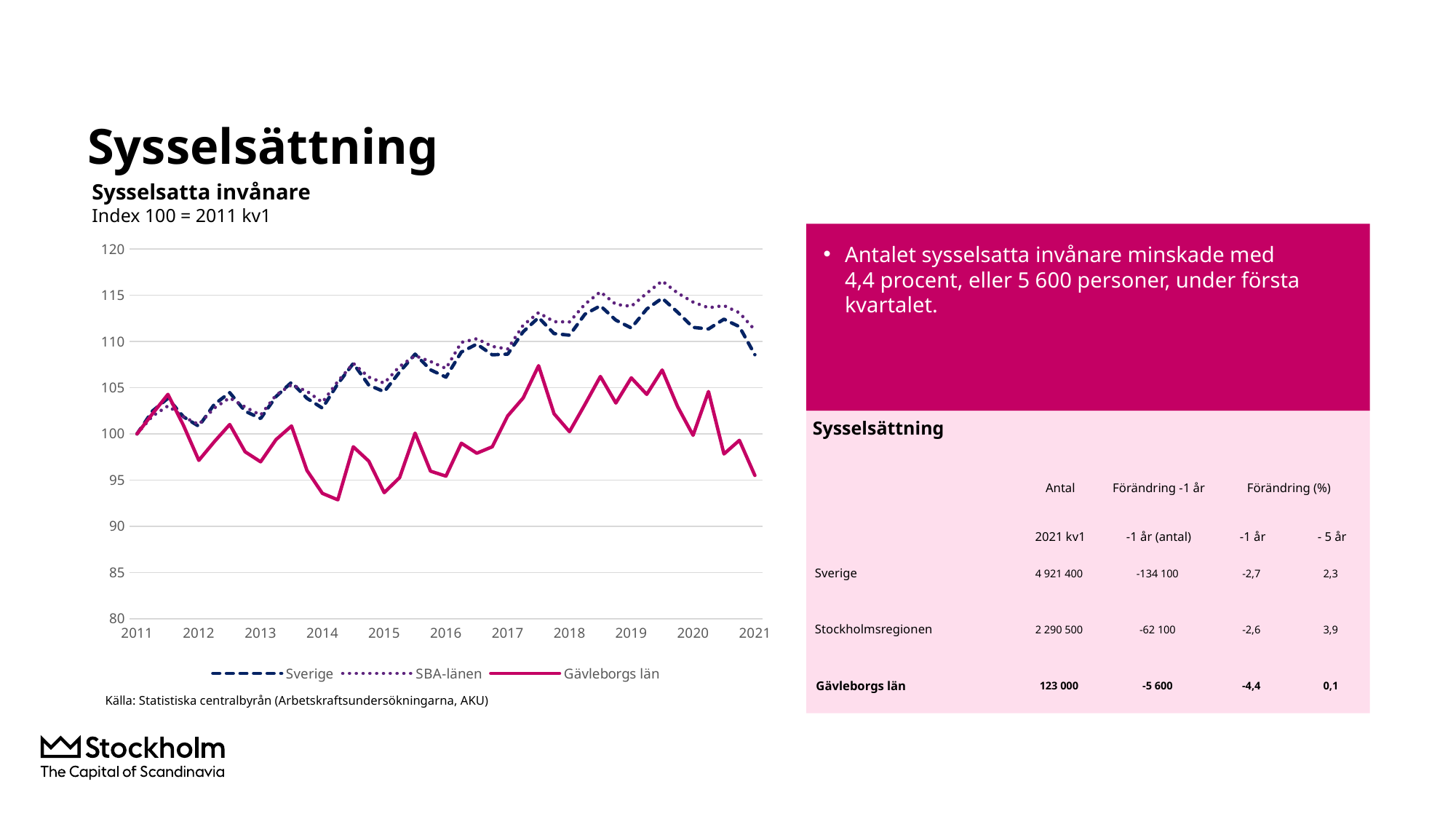
Does the Gävleborgs län line rise or fall between 2020 and 2021? fall Is the value for Sverige at 2021 greater or less than 105? greater How many year labels are shown on the x axis? 11 Is the value for Gävleborgs län at 2014 greater or less than 100? less Which series are listed in the chart legend? Sverige, SBA-länen, Gävleborgs län Which series has the lowest value at 2021? Gävleborgs län Is the value for Gävleborgs län at 2021 greater or less than 100? less What is the title of the chart? Sysselsatta invånare What kind of chart is shown on the slide? line chart How many series does the chart legend list? 3 What is the index value for Sverige at the start of 2011? 100 Which series has the highest value at 2021? SBA-länen